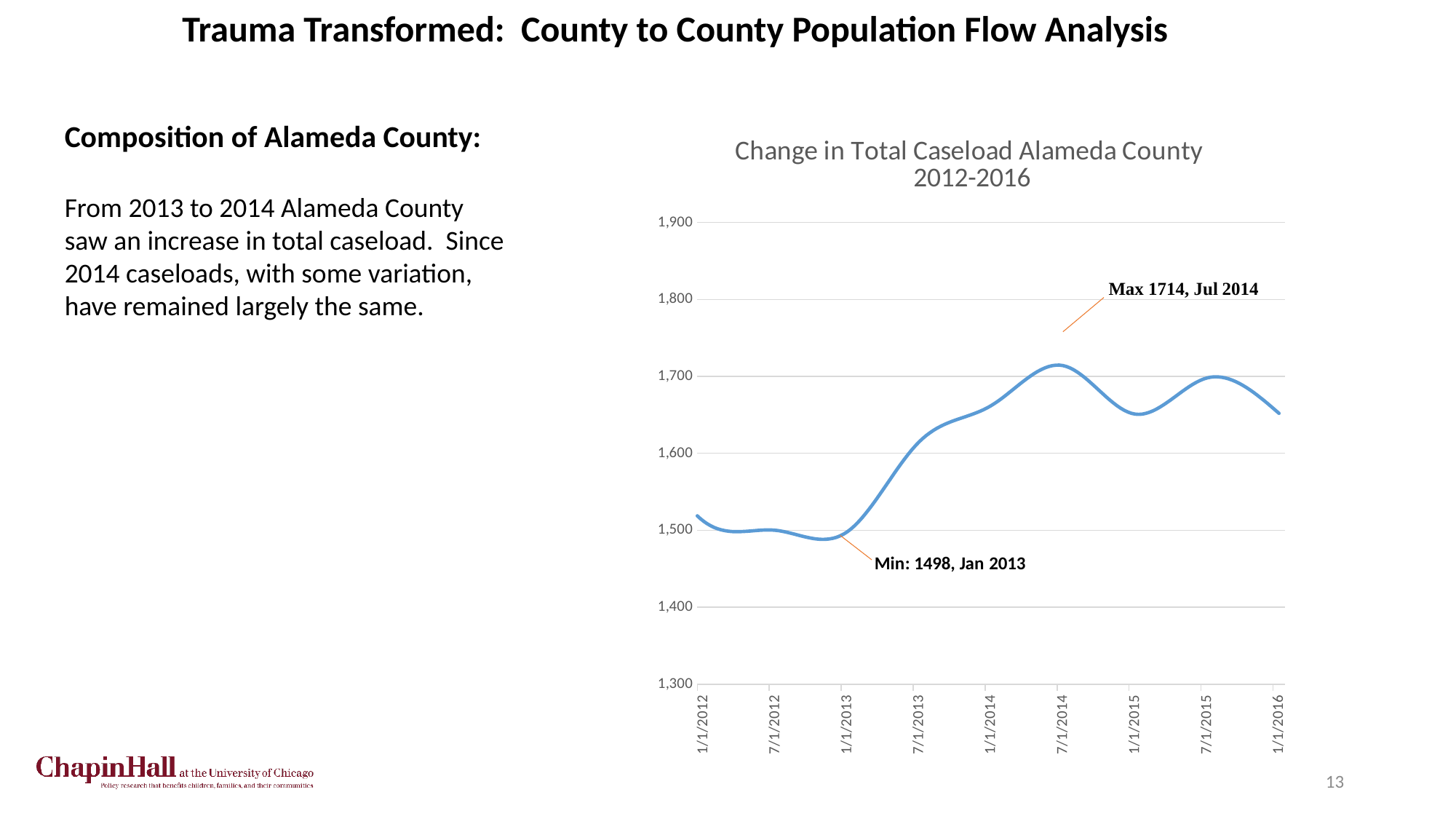
What is the maximum total caseload value labelled on the chart? 1714 What is the difference between the labelled maximum (1714) and minimum (1498) caseload values? 216 Does the caseload rise or fall between 1/1/2013 and 7/1/2014? rise Is the value at 1/1/2016 greater or less than 1,600? greater Is the value at 1/1/2012 greater or less than 1,600? less What kind of chart is shown on the slide? line chart How many date labels are shown on the x axis? 9 What is the minimum total caseload value labelled on the chart? 1498 What is the title of the chart? Change in Total Caseload Alameda County 2012-2016 In which month does the chart label the maximum caseload? Jul 2014 In which month does the chart label the minimum caseload? Jan 2013 Is the value at 7/1/2013 greater or less than 1,700? less